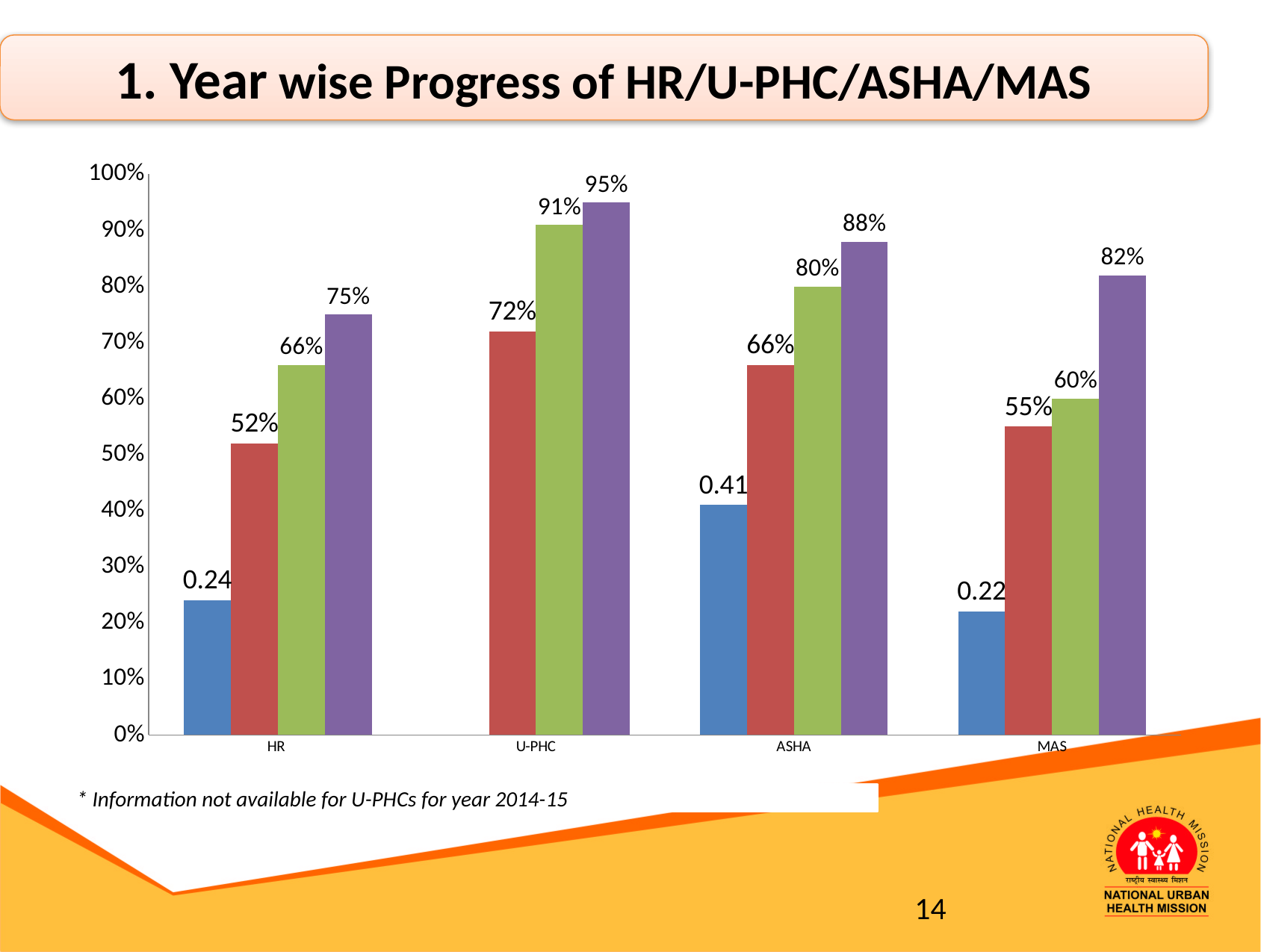
Which category has the lowest blue bar? MAS What type of chart is shown on the slide? bar chart Which category is missing a blue bar? U-PHC What is the value of the purple bar for U-PHC? 95% Within the HR category, do the bars rise or fall from left to right? rise Which is larger, the red bar for U-PHC or the red bar for ASHA? U-PHC How many categories are shown on the x axis of the chart? 4 Which category has the highest purple bar? U-PHC What is the value of the green bar for ASHA? 80% What is the value of the blue bar for HR? 0.24 What is the value of the red bar for MAS? 55% What is the difference between the purple bar and the green bar for MAS? 22%